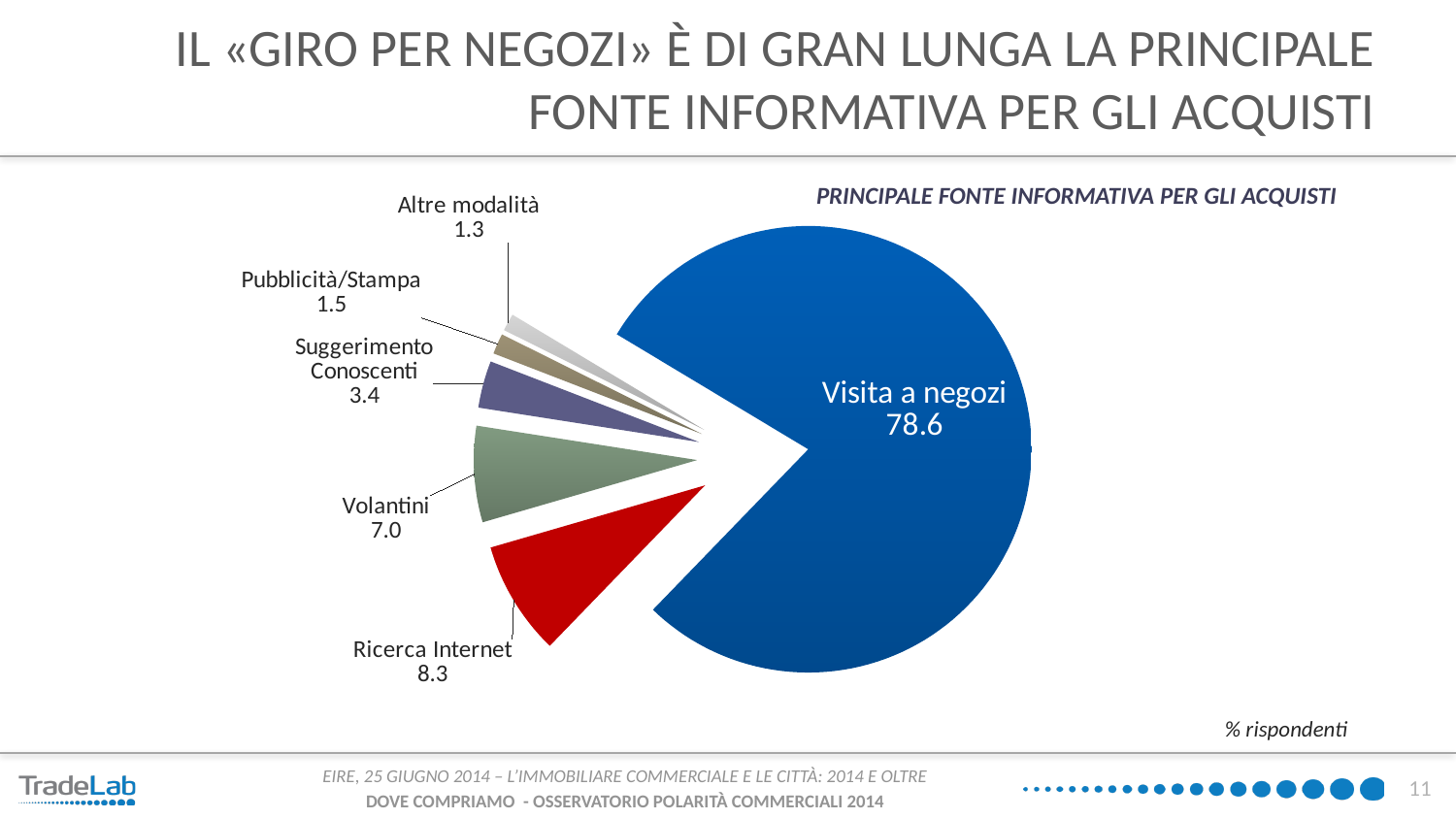
What is the value for Suggerimento Conoscenti? 3.4 What is the value for Visita a negozi? 78.6 Which category has the largest slice of the pie? Visita a negozi Which category has the smallest slice of the pie? Altre modalità What is the value for Volantini? 7.0 How many slices does the pie chart have? 6 What is the difference between the values for Ricerca Internet and Volantini? 1.3 What is the value for Ricerca Internet? 8.3 Which is larger, the value for Pubblicità/Stampa or the value for Altre modalità? Pubblicità/Stampa What is the title of the chart? PRINCIPALE FONTE INFORMATIVA PER GLI ACQUISTI What type of chart is shown on the slide? Pie chart What colour is the Ricerca Internet slice? Red